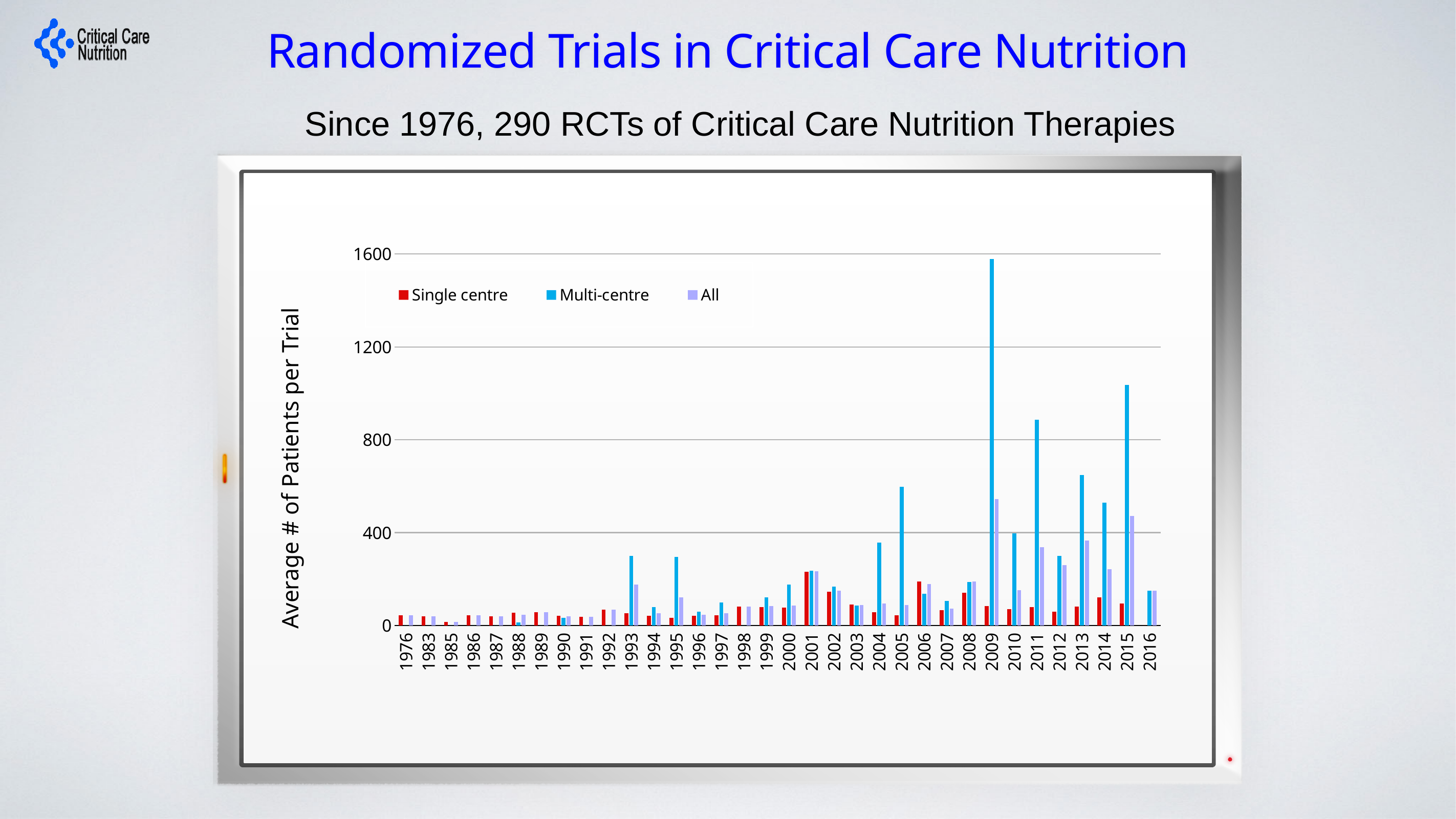
How many series does the chart's legend list? 3 Which is larger, the Multi-centre value for 2013 or for 2014? 2013 What is the title of the chart's vertical axis? Average # of Patients per Trial Is the All value for 2009 greater or less than 400? greater Is the Multi-centre value for 2009 greater or less than 1200? greater What kind of chart is shown on the slide? Bar chart How many years are shown along the x axis of the chart? 34 Is the Multi-centre value for 2005 greater or less than 400? greater Which is larger, the Multi-centre value for 2009 or for 2015? 2009 Which year has the highest Multi-centre value? 2009